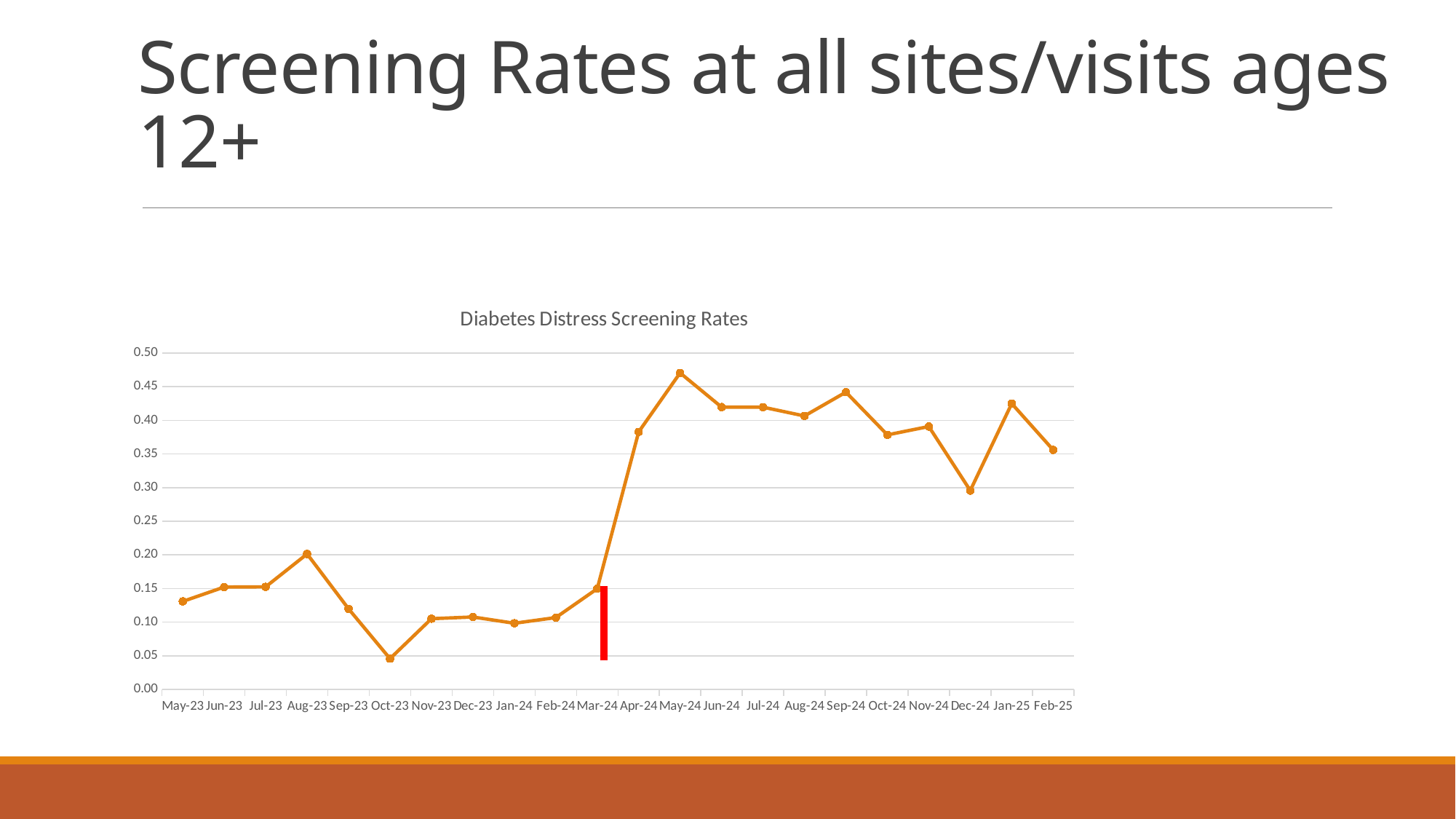
Which month has the highest screening rate? May-24 Which is larger, the value for Nov-24 or the value for Dec-24? Nov-24 How many monthly data points are plotted on the chart? 22 Is the value for Sep-23 greater or less than 0.10? greater What kind of chart is shown on the slide? line chart Which is larger, the value for Aug-23 or the value for Sep-23? Aug-23 Which month has the lowest screening rate? Oct-23 Is the value for Sep-24 greater or less than 0.40? greater What is the title of the chart? Diabetes Distress Screening Rates Is the value for Apr-24 greater or less than 0.35? greater Do the values rise or fall from Mar-24 to May-24? rise